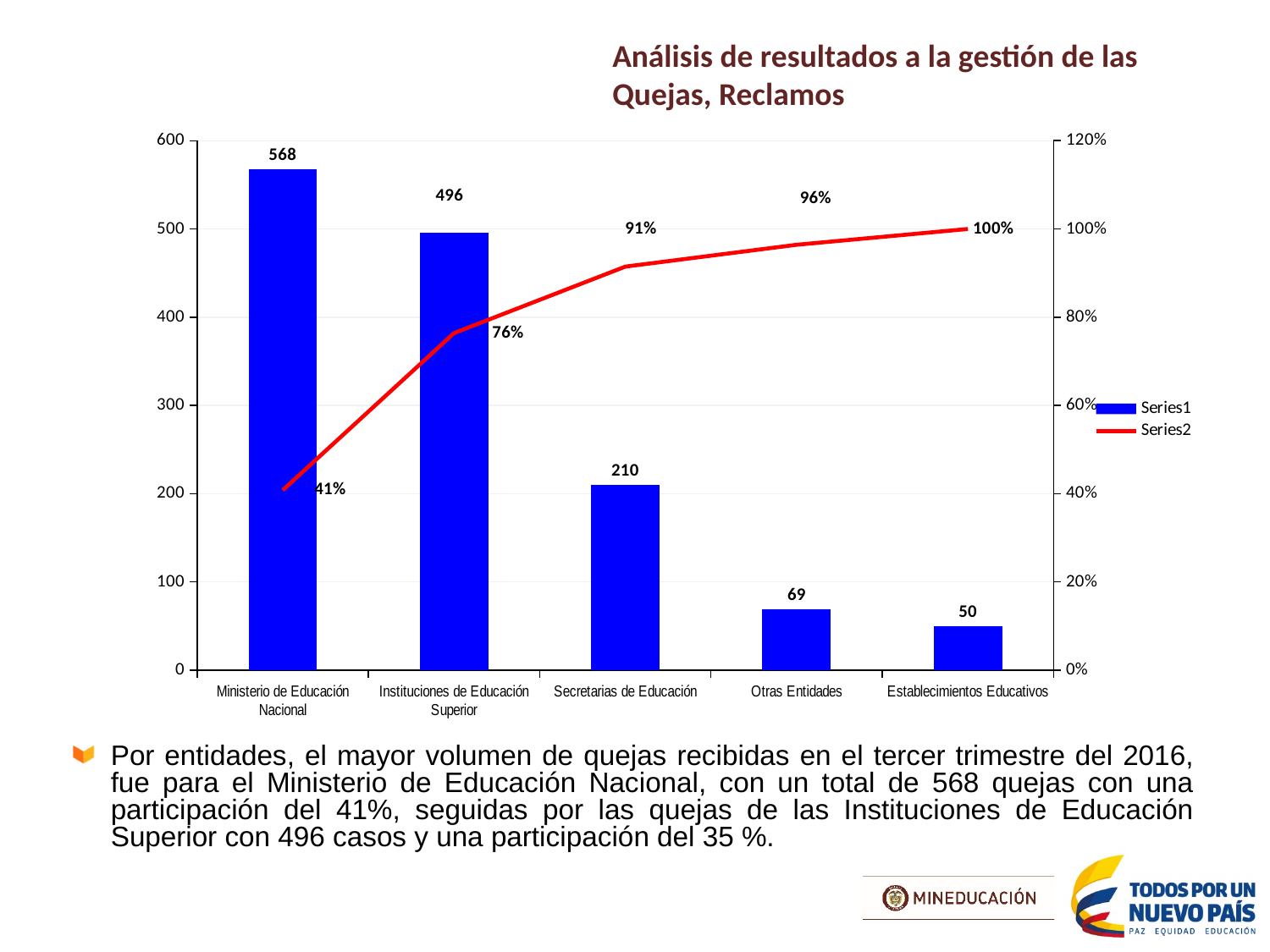
Does the Series2 line rise or fall from left to right across the categories? Rise Which category has the highest Series1 value? Ministerio de Educación Nacional How many series does the legend list? 2 What is the Series2 percentage for Establecimientos Educativos? 100% What is the difference between the Series1 values for Ministerio de Educación Nacional and Instituciones de Educación Superior? 72 Which category has the lowest Series1 value? Establecimientos Educativos Which is larger, the Series1 value for Otras Entidades or for Establecimientos Educativos? Otras Entidades How many categories are shown on the x axis? 5 What is the Series2 percentage for Instituciones de Educación Superior? 76% What is the Series1 value for Otras Entidades? 69 What kind of chart is shown on the slide? Combined bar and line chart What is the Series1 value for Secretarias de Educación? 210